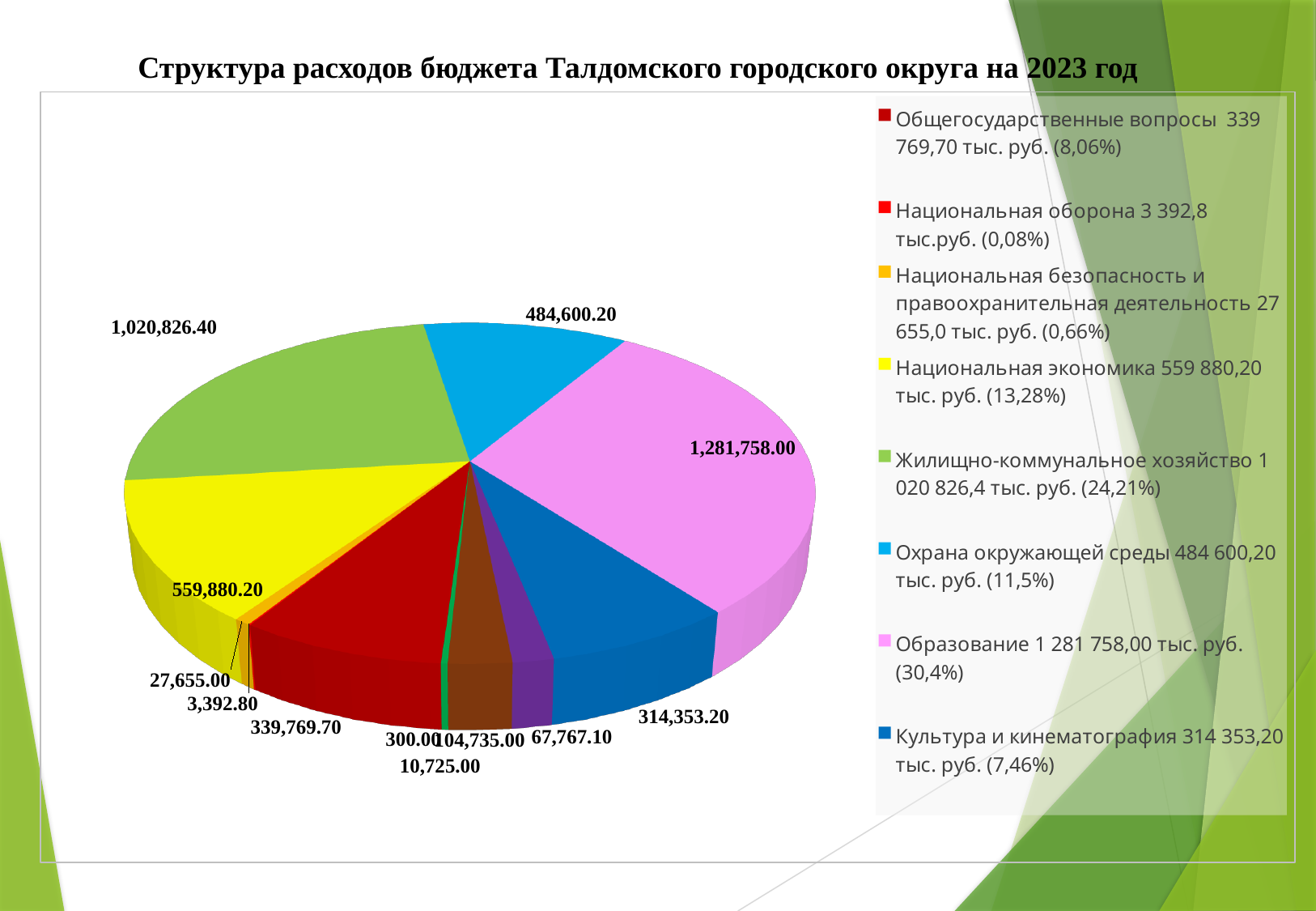
According to the legend, what share of the pie does Образование represent? 30,4% What value is labeled on the slice for Образование? 1,281,758.00 What value is labeled on the slice for Жилищно-коммунальное хозяйство? 1,020,826.40 Which is larger, the slice for Национальная экономика or the slice for Охрана окружающей среды? Национальная экономика According to the legend, what share of the pie does Национальная экономика represent? 13,28% Which category has the largest slice of the pie? Образование What is the title of the chart? Структура расходов бюджета Талдомского городского округа на 2023 год What value is labeled on the slice for Культура и кинематография? 314,353.20 What kind of chart is shown on the slide? pie chart What value is labeled on the slice for Охрана окружающей среды? 484,600.20 What value is labeled on the slice for Национальная оборона? 3,392.80 What is the smallest value labeled on the pie? 300.00